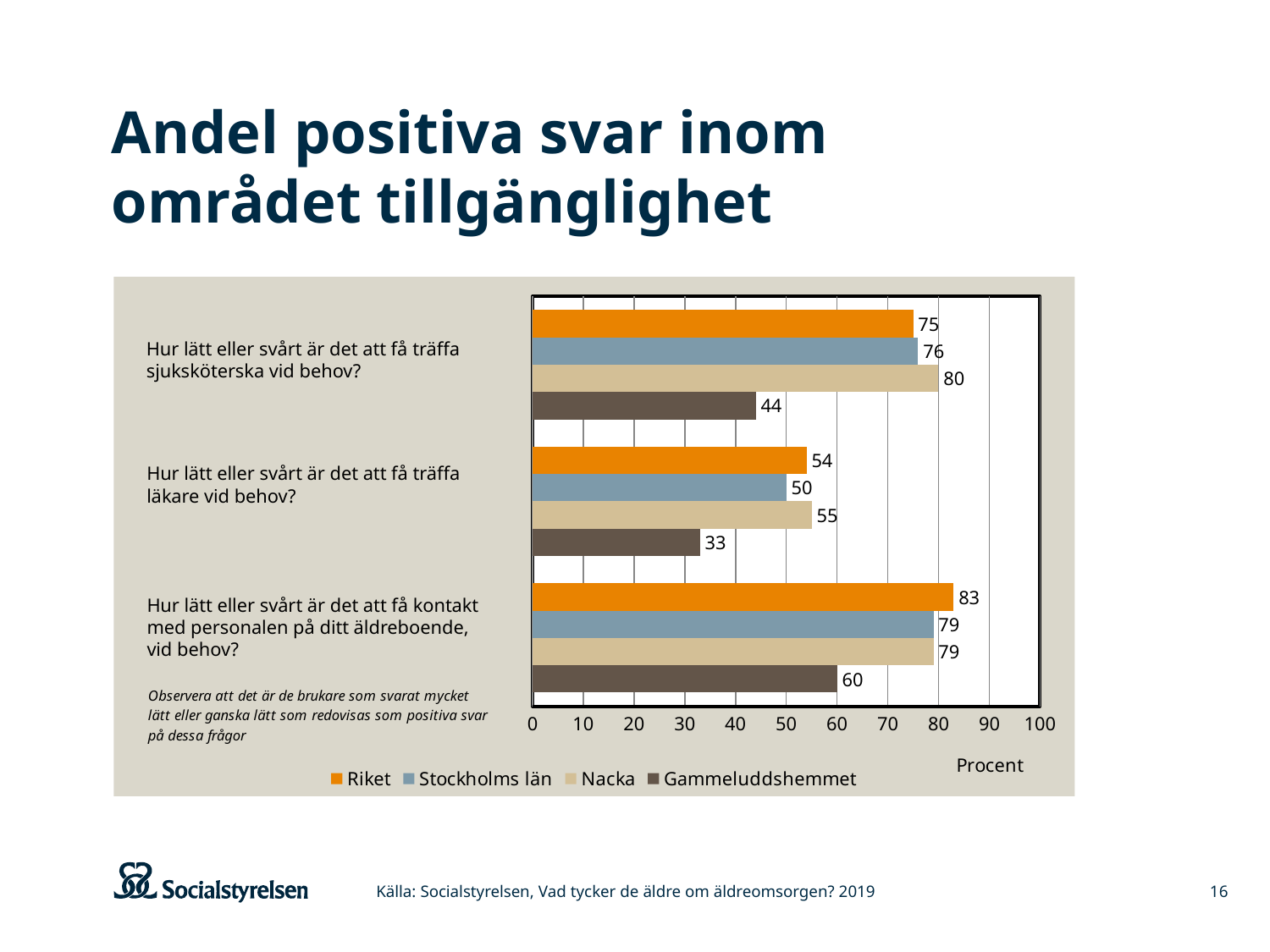
Which series has the highest value for the question about meeting a nurse (sjuksköterska) when needed? Nacka Which series has the lowest value for the question about meeting a doctor (läkare) when needed? Gammeluddshemmet Which is larger for the question about contact with staff at the care home: Riket or Gammeluddshemmet? Riket How many question categories are shown on the y axis of the chart? 3 What is the value for Nacka for the question about meeting a doctor (läkare) when needed? 55 How many series does the legend list? 4 What is the value for Gammeluddshemmet for the question about meeting a nurse (sjuksköterska) when needed? 44 What is the difference between Riket and Stockholms län for the question about meeting a doctor (läkare) when needed? 4 What is the value for Riket for the question about getting in contact with staff at the care home (äldreboende)? 83 What is the difference between Nacka and Gammeluddshemmet for the question about meeting a nurse (sjuksköterska) when needed? 36 What kind of chart is shown on the slide? bar chart What label is shown on the x axis of the chart? Procent